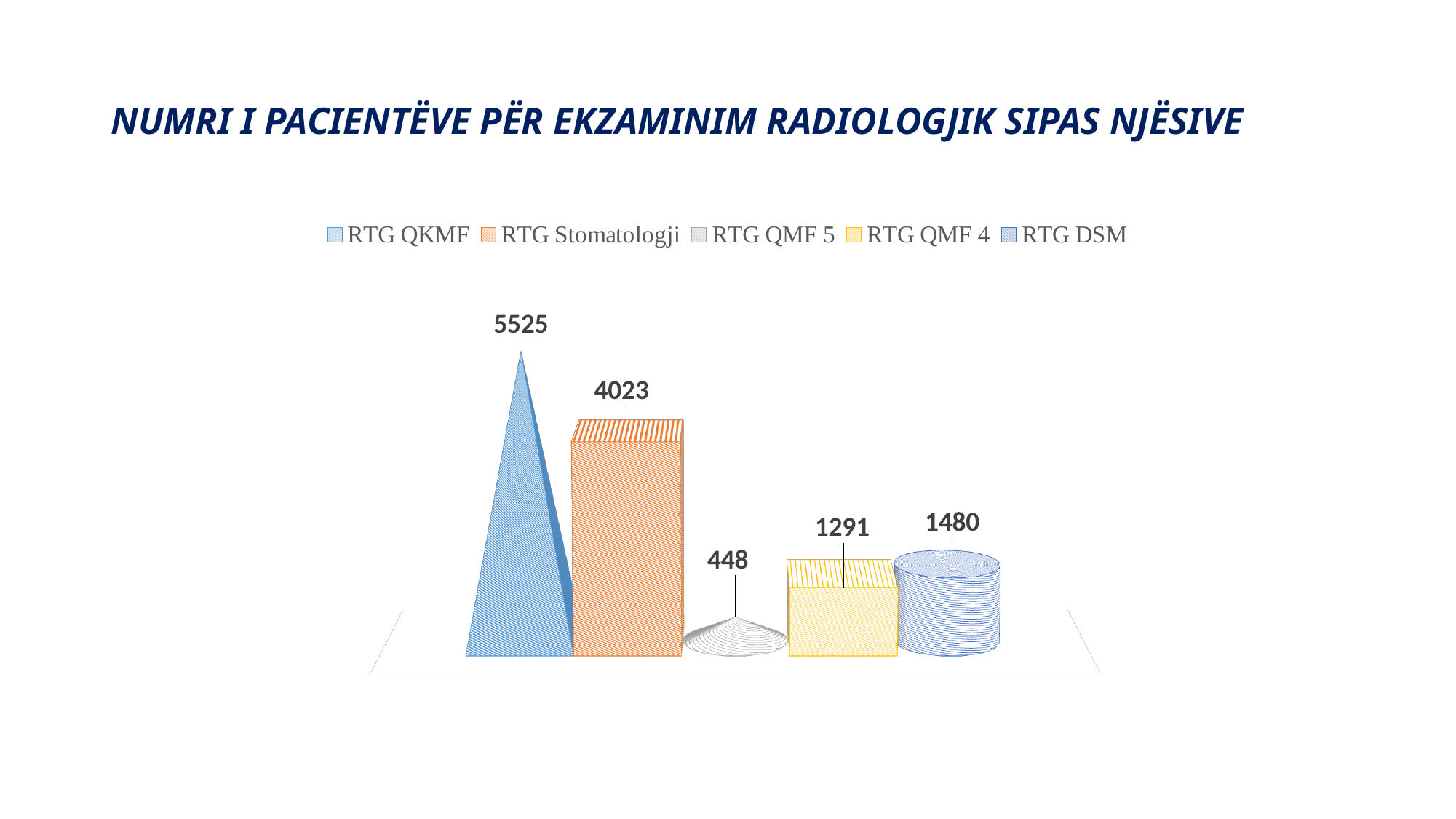
What is the value for RTG QMF 5? 448 Which is larger, the value for RTG DSM or the value for RTG QMF 4? RTG DSM Which unit has the lowest number of patients? RTG QMF 5 What is the value for RTG DSM? 1480 What is the value for RTG QKMF? 5525 What is the difference between the values for RTG QKMF and RTG Stomatologji? 1502 What kind of chart is shown on the slide? Bar chart What is the value for RTG QMF 4? 1291 How many series does the legend list? 5 What is the title of the chart? NUMRI I PACIENTËVE PËR EKZAMINIM RADIOLOGJIK SIPAS NJËSIVE Which unit has the highest number of patients? RTG QKMF What is the value for RTG Stomatologji? 4023